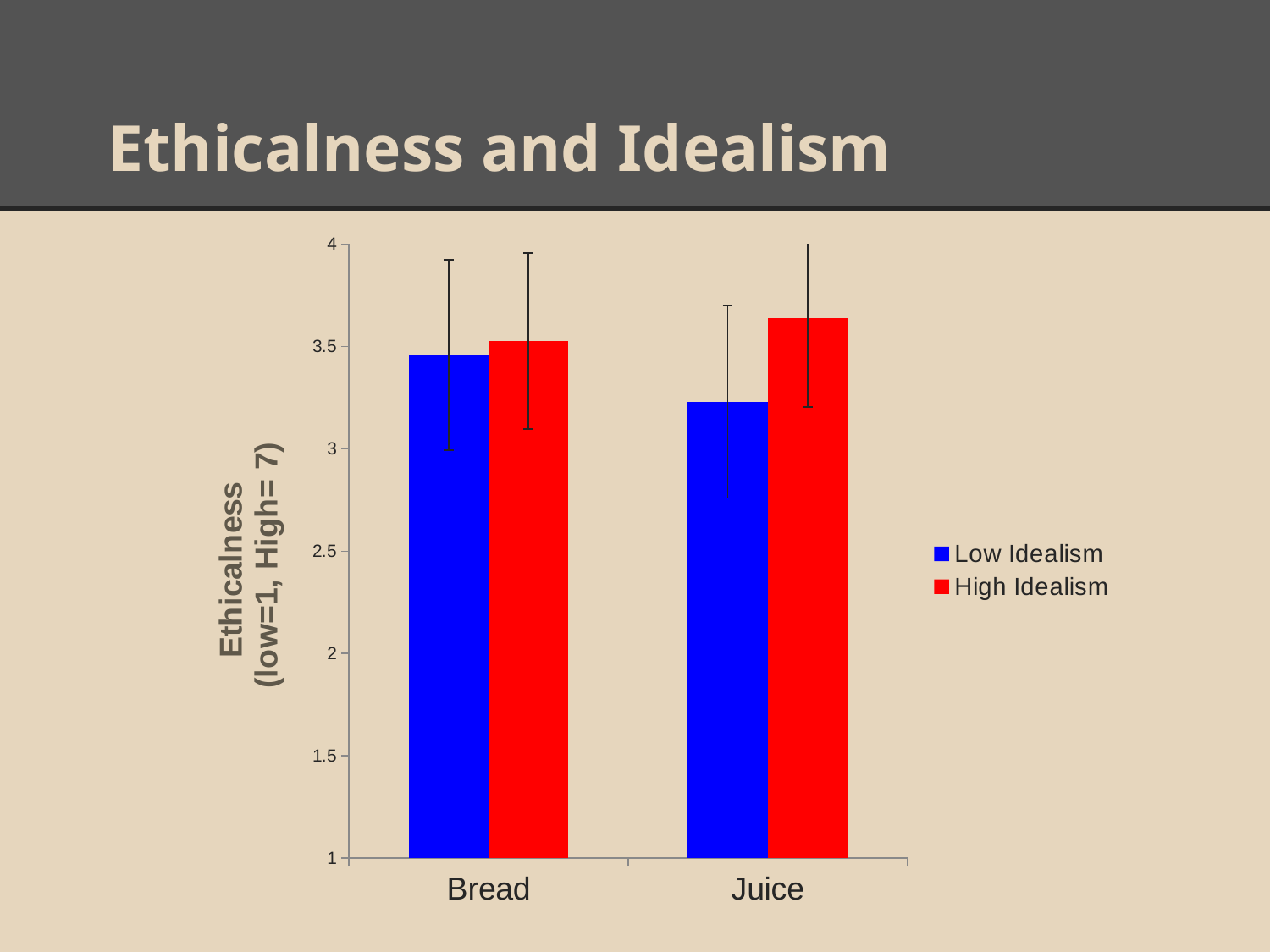
How many series does the legend list? 2 Which series has the lowest bar in the chart? Low Idealism (Juice) Is the High Idealism value for Juice greater or less than 3.5? greater How many categories are shown on the x axis? 2 Is the Low Idealism value for Juice greater or less than 3.5? less What is the title of the slide containing the chart? Ethicalness and Idealism Which bar is the highest in the chart? High Idealism for Juice For the Low Idealism series, which category has the larger value: Bread or Juice? Bread What kind of chart is shown on the slide? bar chart Is the Low Idealism value for Bread greater or less than 3? greater What colour represents the Low Idealism series? blue For Juice, which is larger: Low Idealism or High Idealism? High Idealism